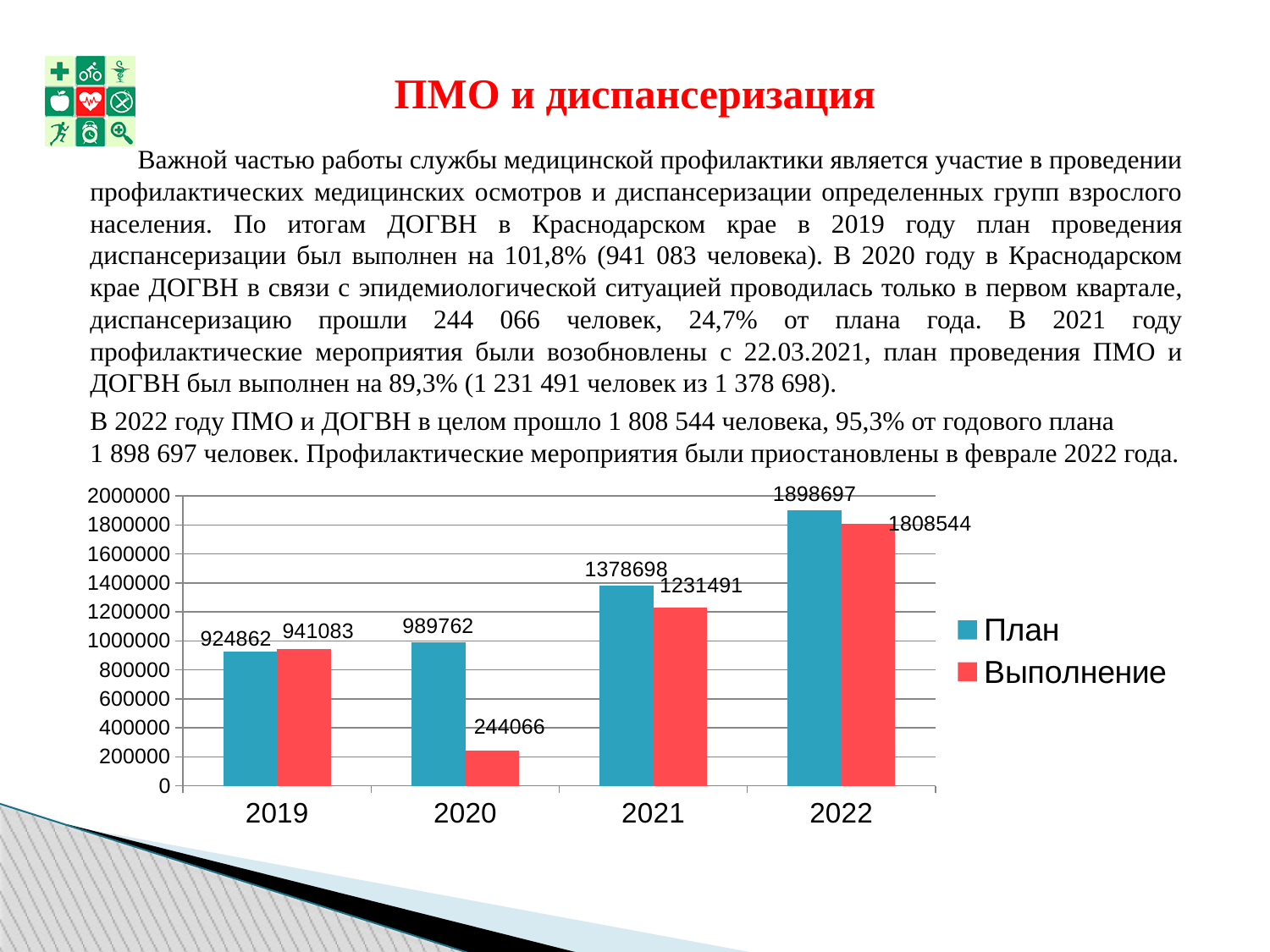
What type of chart is shown on the slide? bar chart Is the Выполнение value for 2021 greater or less than 1000000? greater In which year is the Выполнение value the lowest? 2020 Does the План value rise or fall from 2019 to 2022? rise What is the difference between План and Выполнение in 2022? 90153 What is the value of План for 2021? 1378698 How many series does the legend list? 2 What is the value of Выполнение for 2020? 244066 What is the value of Выполнение for 2019? 941083 How many years are shown on the x axis? 4 Which is larger in 2019, План or Выполнение? Выполнение In which year is the План value the highest? 2022